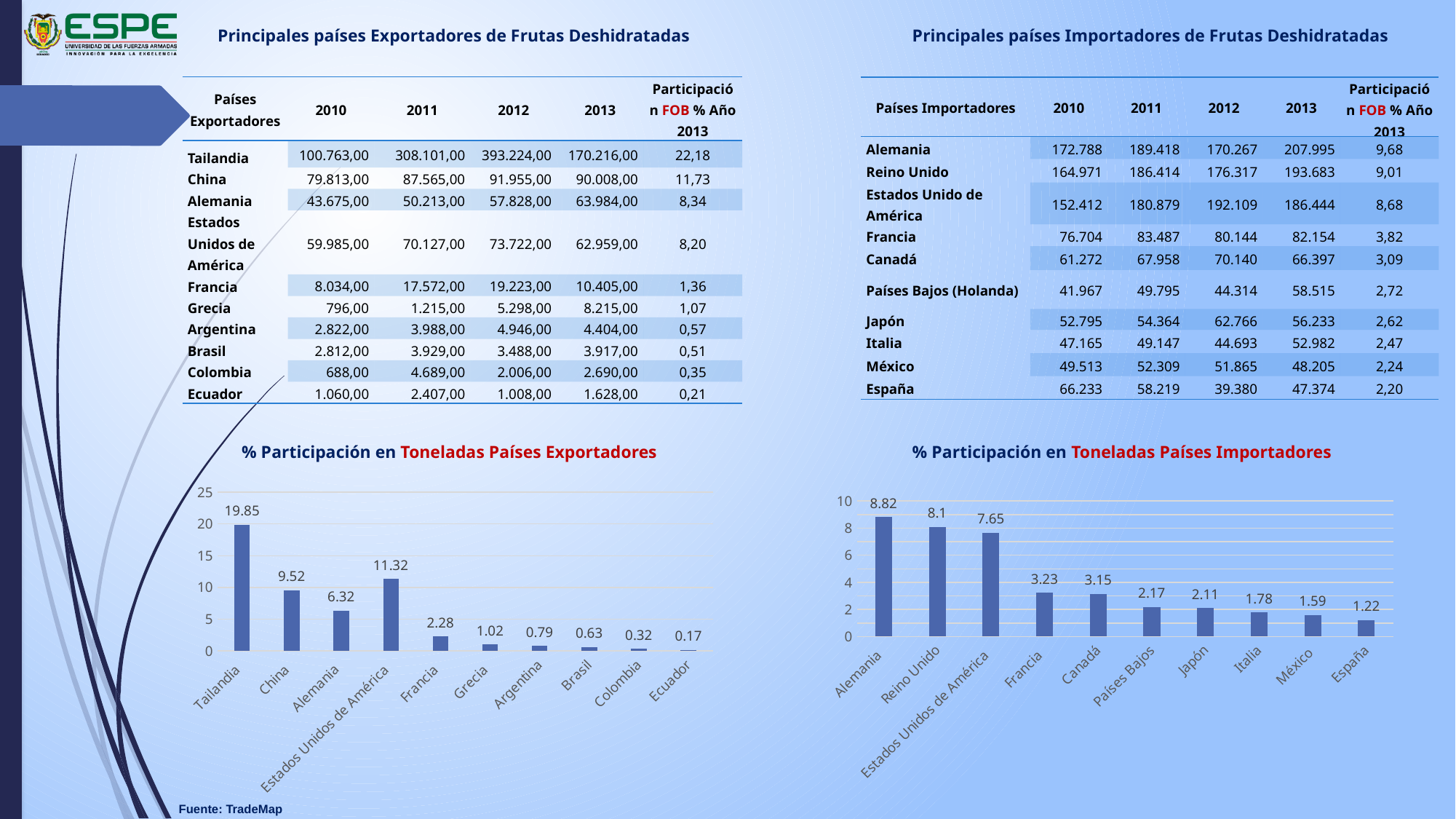
In the chart '% Participación en Toneladas Países Importadores', what is the value for Japón? 2.11 In the chart '% Participación en Toneladas Países Exportadores', what is the value for Estados Unidos de América? 11.32 In the chart '% Participación en Toneladas Países Importadores', do the values generally rise or fall from left to right along the x axis? Fall In the chart '% Participación en Toneladas Países Importadores', which country has the highest value? Alemania In the chart '% Participación en Toneladas Países Exportadores', which country has the lowest value? Ecuador In the chart '% Participación en Toneladas Países Exportadores', how many countries are shown? 10 In the chart '% Participación en Toneladas Países Exportadores', which is larger, the value for Francia or the value for Grecia? Francia What kind of chart is '% Participación en Toneladas Países Importadores'? Bar chart In the chart '% Participación en Toneladas Países Exportadores', what is the difference between the values for China and Alemania? 3.2 In the chart '% Participación en Toneladas Países Importadores', what is the value for Alemania? 8.82 In the chart '% Participación en Toneladas Países Exportadores', what is the value for Tailandia? 19.85 In the chart '% Participación en Toneladas Países Importadores', what is the difference between the values for Reino Unido and Estados Unidos de América? 0.45